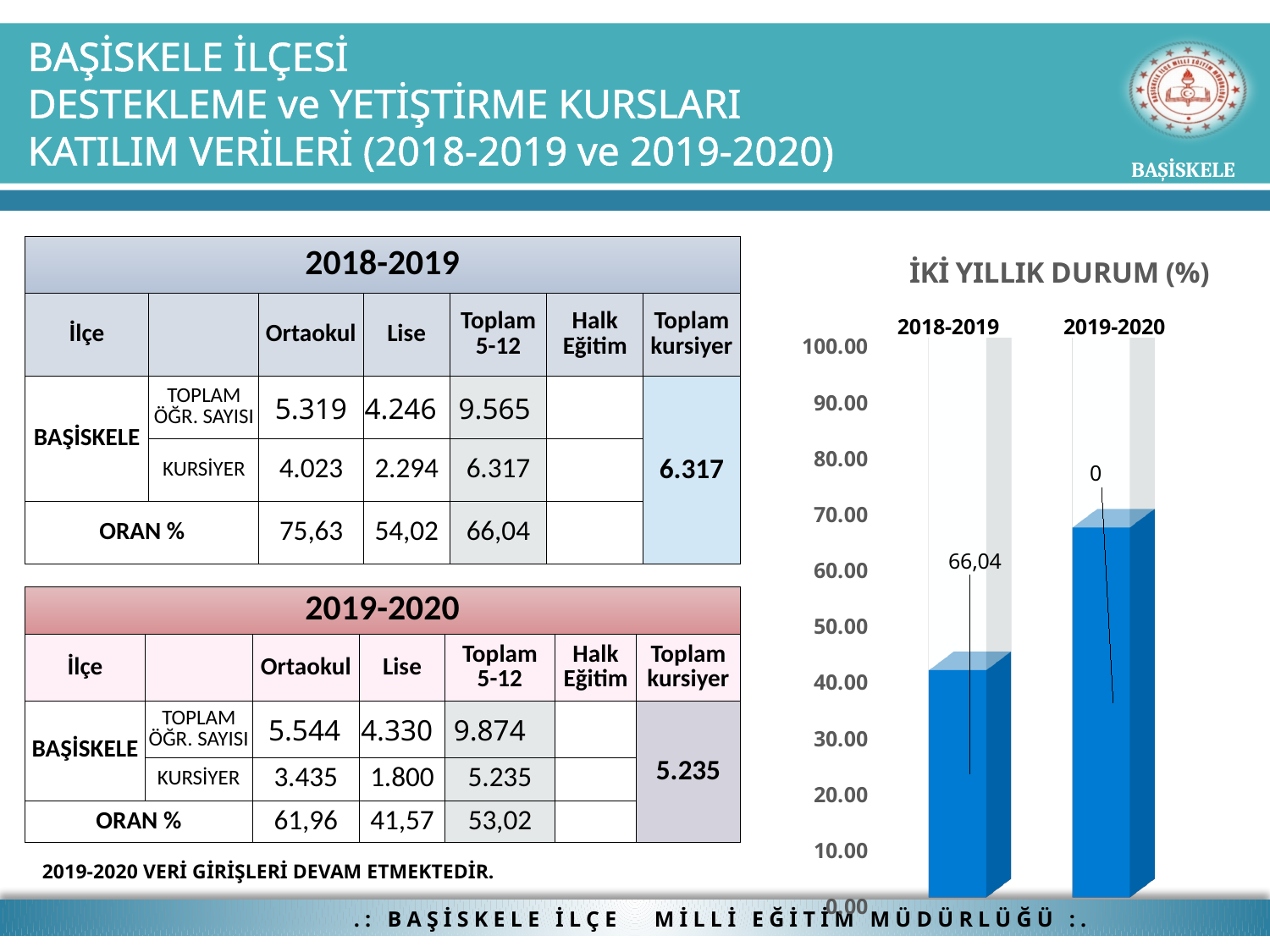
How many bars (categories) does the chart show? 2 What is the title of the chart? İKİ YILLIK DURUM (%) What data label is printed on the bar for 2019-2020? 0 What kind of chart is shown on the slide? bar chart What data label is printed on the bar for 2018-2019? 66,04 Which two categories are shown on the x axis of the chart? 2018-2019 and 2019-2020 What is the lowest value shown on the chart's y axis? 0.00 What is the highest value shown on the chart's y axis? 100.00